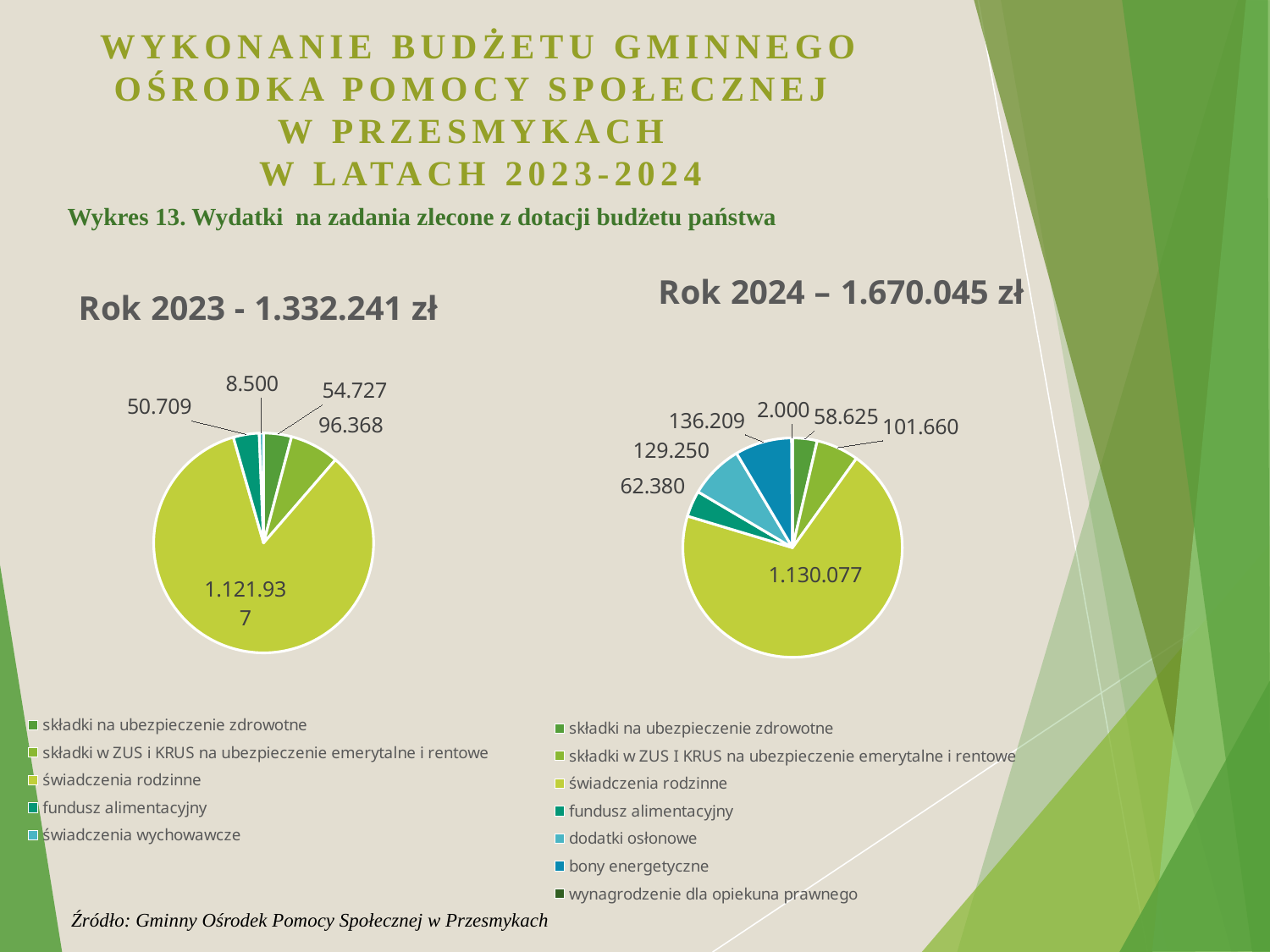
In the Rok 2023 pie chart, what is the difference between the slices labelled 96.368 and 54.727? 41.641 In the Rok 2024 pie chart, what is the value of the smallest slice? 2.000 What kind of chart is used for Rok 2023 on the slide? pie chart In the Rok 2024 pie chart, what is the value of the largest slice? 1.130.077 In the Rok 2023 pie chart, what is the value of the largest slice? 1.121.937 In the Rok 2023 pie chart, what is the value of the smallest slice? 8.500 How many entries does the legend of the Rok 2024 pie chart list? 7 In the Rok 2023 pie chart, how many slices are there? 5 In the Rok 2024 pie chart, what is the difference between the slices labelled 129.250 and 62.380? 66.870 What is the number and title of the chart (Wykres) shown on the slide? Wykres 13. Wydatki na zadania zlecone z dotacji budżetu państwa What total amount is given in the title of the Rok 2024 pie chart? 1.670.045 zł In the Rok 2024 pie chart, which is larger: the slice labelled 136.209 or the slice labelled 129.250? 136.209